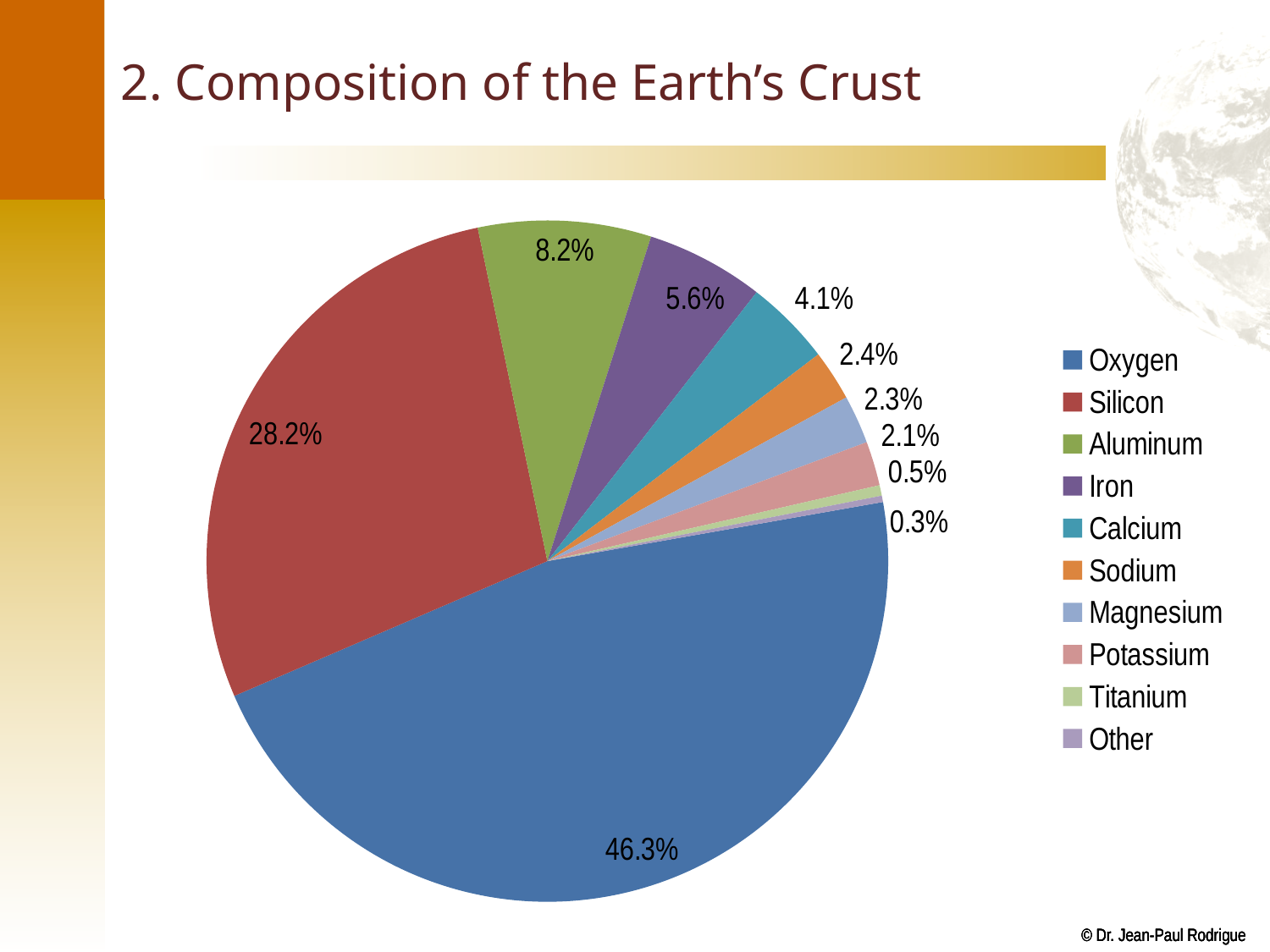
What kind of chart is shown on the slide? Pie chart What is the title of the slide containing the chart? 2. Composition of the Earth's Crust What percentage is shown for Calcium? 4.1% What share of the pie does Oxygen account for? 46.3% Which element has the largest slice of the pie? Oxygen What is the difference between the Oxygen and Silicon shares? 18.1% What is the value shown for Iron? 5.6% Which category has the smallest slice of the pie? Other How many categories does the legend list? 10 What is the value shown for Silicon? 28.2% Which is larger, the share for Aluminum or the share for Iron? Aluminum What percentage is shown for Aluminum? 8.2%